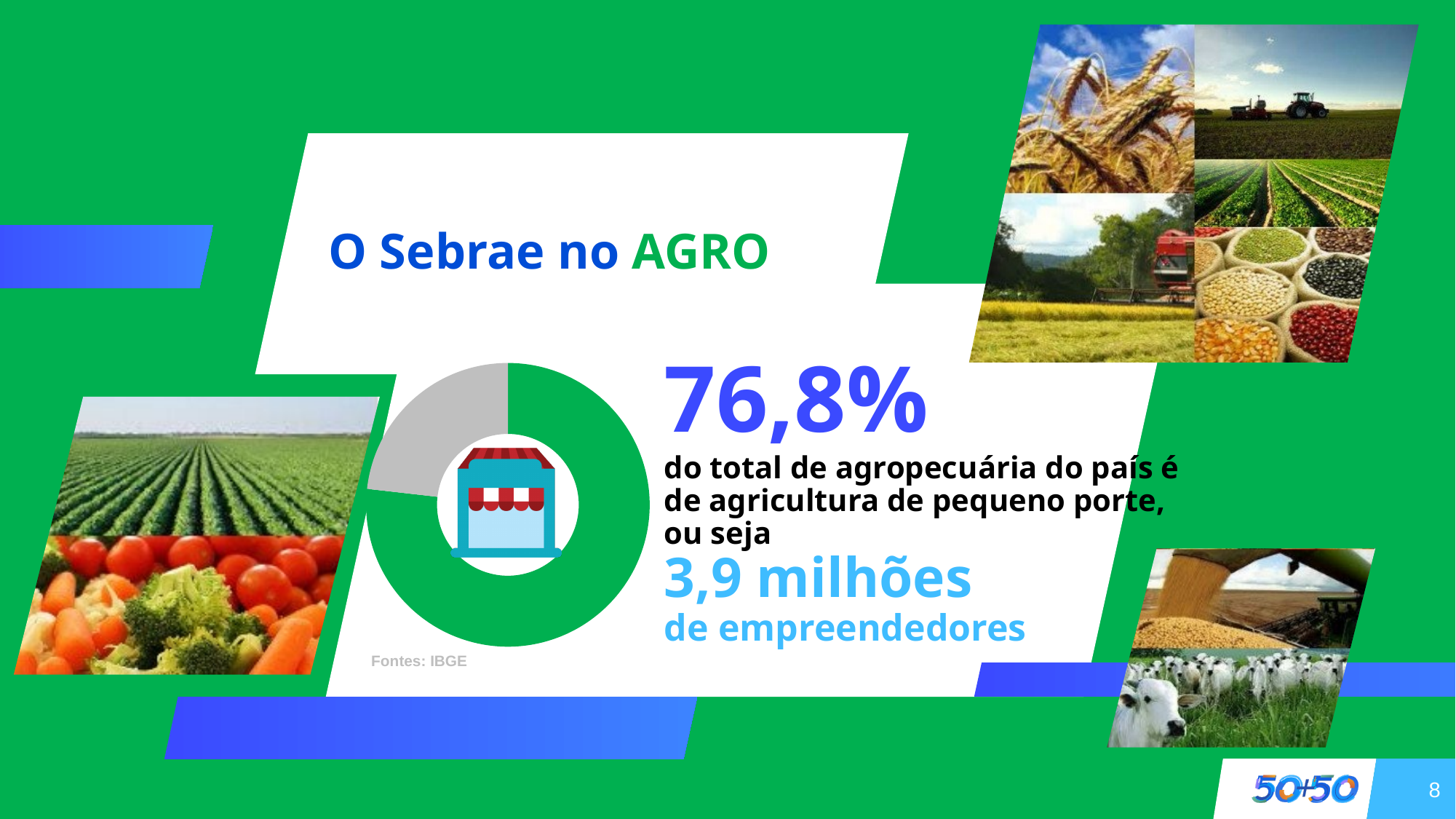
Is the share shown by the green slice of the donut chart greater or less than 50%? greater What number of entrepreneurs does the slide say corresponds to the 76,8% share? 3,9 milhões How many slices does the donut chart have? 2 Which slice of the donut chart is larger, the green one or the grey one? The green one What share of the donut chart does the green slice represent? 76,8% What source is cited below the donut chart? IBGE What kind of chart is shown on the slide? Donut (pie) chart Is the share shown by the grey slice of the donut chart greater or less than 50%? less